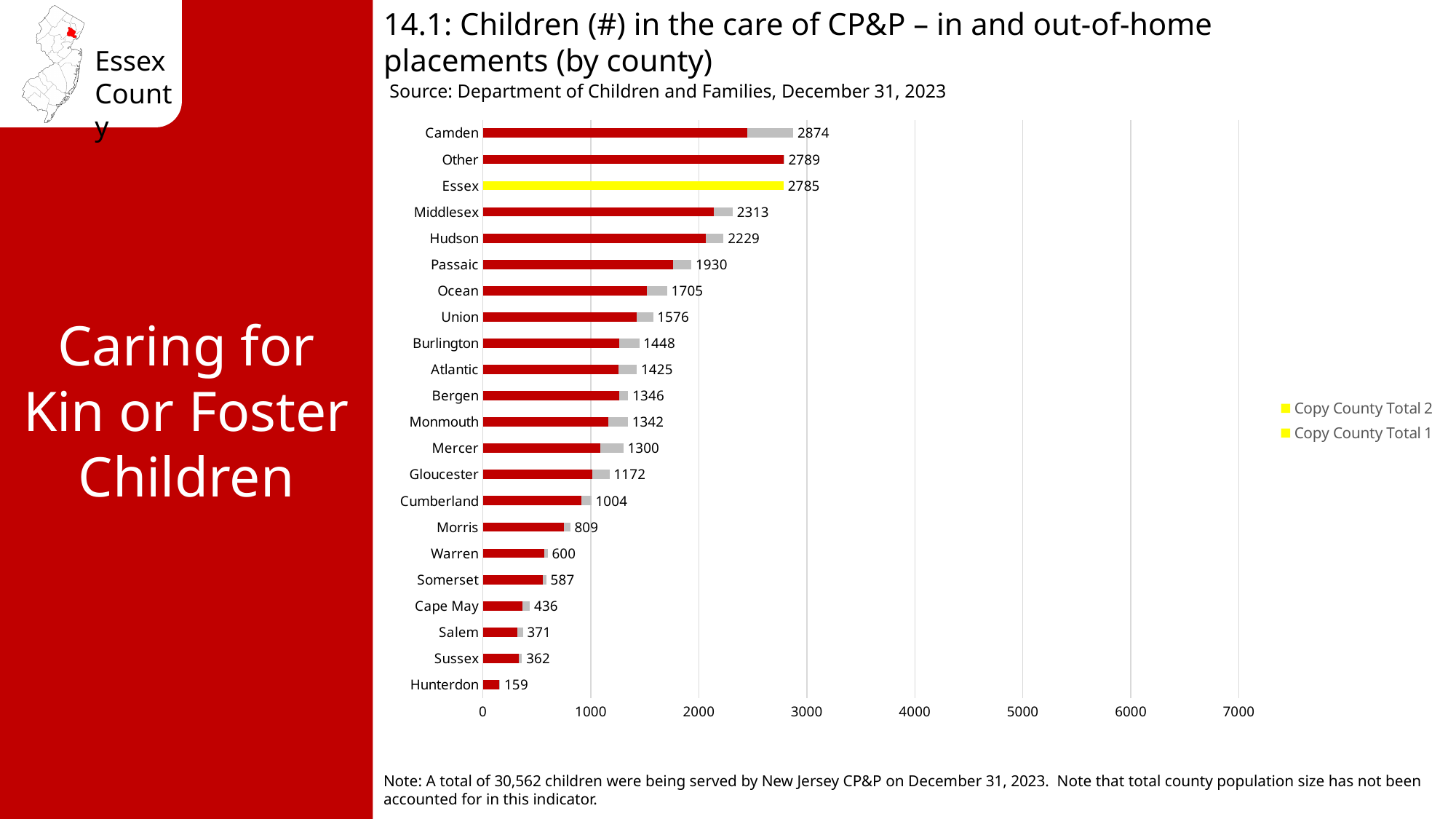
Is the value for Essex greater or less than 2000? greater Which county's bar is highlighted in yellow? Essex Which county has the highest number of children in the care of CP&P? Camden What value is shown for Hudson County? 2229 What is the total number of children in the care of CP&P for Essex County? 2785 Which has a larger value, Middlesex or Union? Middlesex What is the difference between the values for Camden and Essex? 89 What is the difference between the values for Passaic and Ocean? 225 What kind of chart is used on this slide? Bar chart Which county has the lowest number of children in the care of CP&P? Hunterdon How many counties (categories) are shown on the chart? 22 What value is shown for Cumberland County? 1004